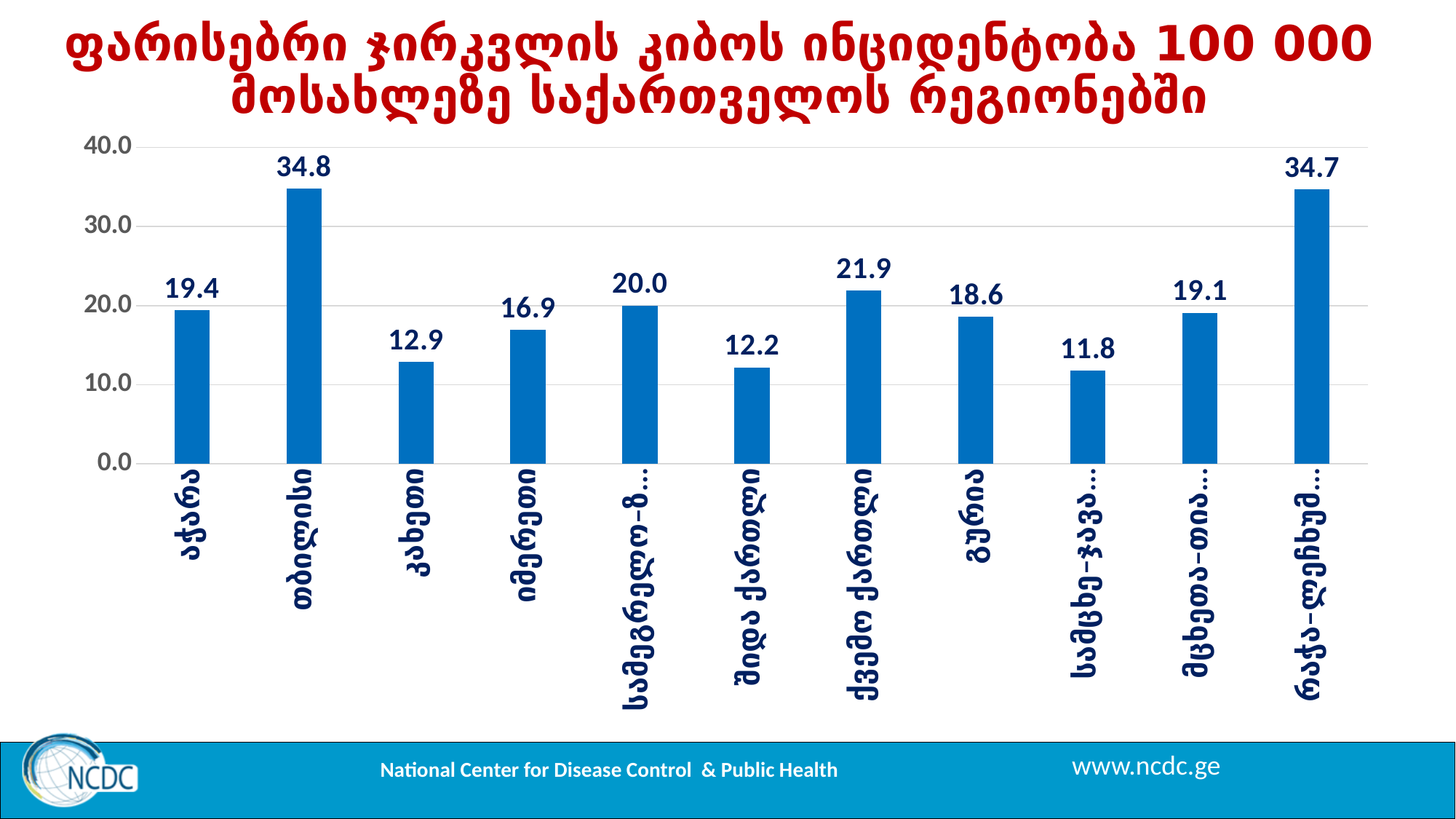
Which has the higher value, თბილისი or კახეთი? თბილისი What is the value for აჭარა? 19.4 How many regions (bars) are shown in the chart? 11 What kind of chart is shown on the slide? bar chart What is the value for შიდა ქართლი? 12.2 What is the value for ქვემო ქართლი? 21.9 What is the difference between the values for ქვემო ქართლი and შიდა ქართლი? 9.7 What is the difference between the values for თბილისი and აჭარა? 15.4 What is the value for იმერეთი? 16.9 What is the value for თბილისი? 34.8 Is the value for კახეთი greater or less than 20.0? less What is the value for გურია? 18.6